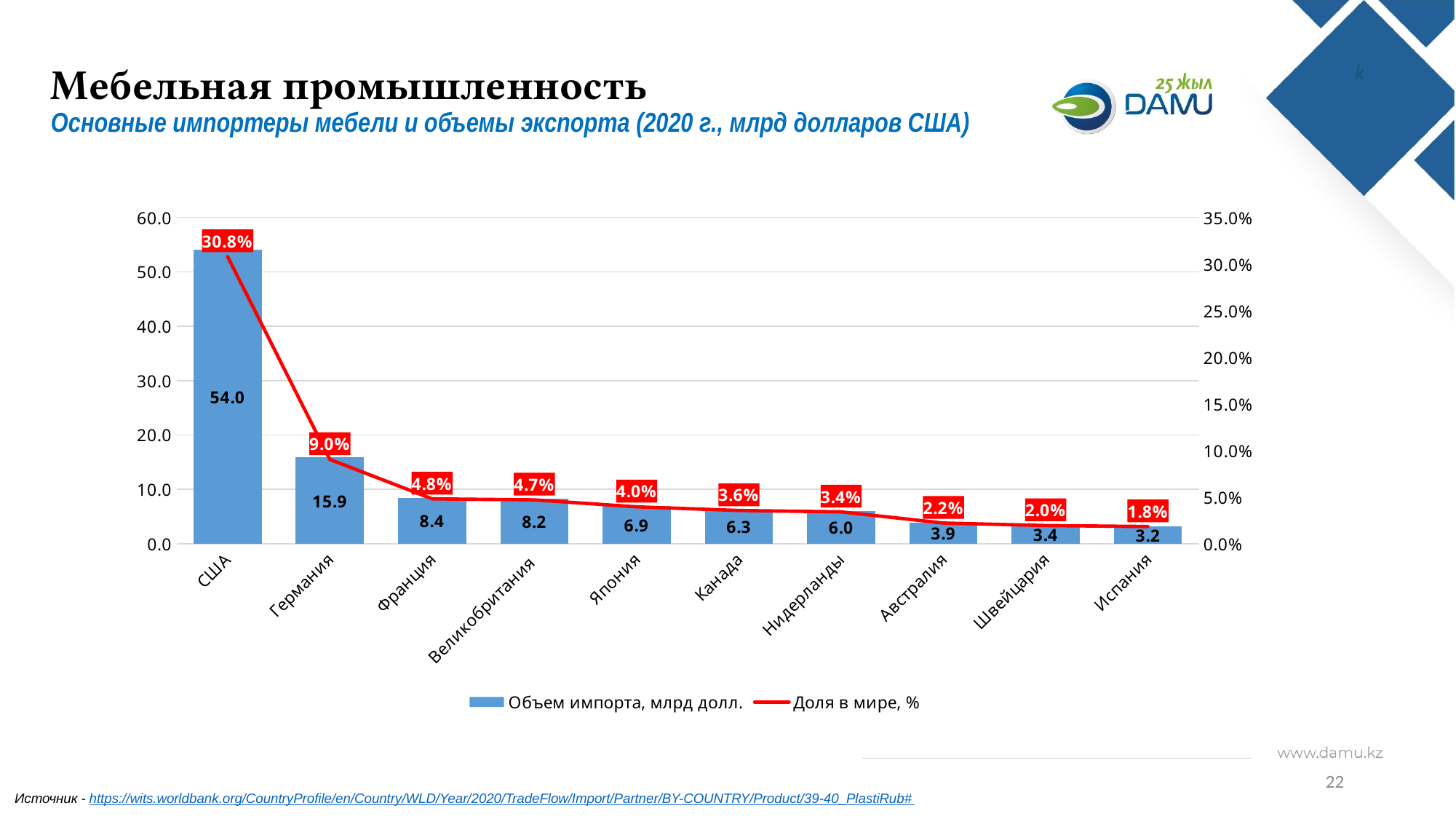
Which has a larger import volume, Франция or Япония? Франция What is the world share for Испания? 1.8% What colour is the line showing Доля в мире, %? red What is the difference in import volume between США and Германия? 38.1 Do the import volumes rise or fall from left to right along the x axis? fall Which country has the lowest import volume? Испания Which country has the highest import volume? США How many countries are shown on the x axis? 10 How many series does the legend list? 2 What is the world share (Доля в мире, %) for Германия? 9.0% What is the import volume for Нидерланды? 6.0 What is the import volume (Объем импорта, млрд долл.) for США? 54.0